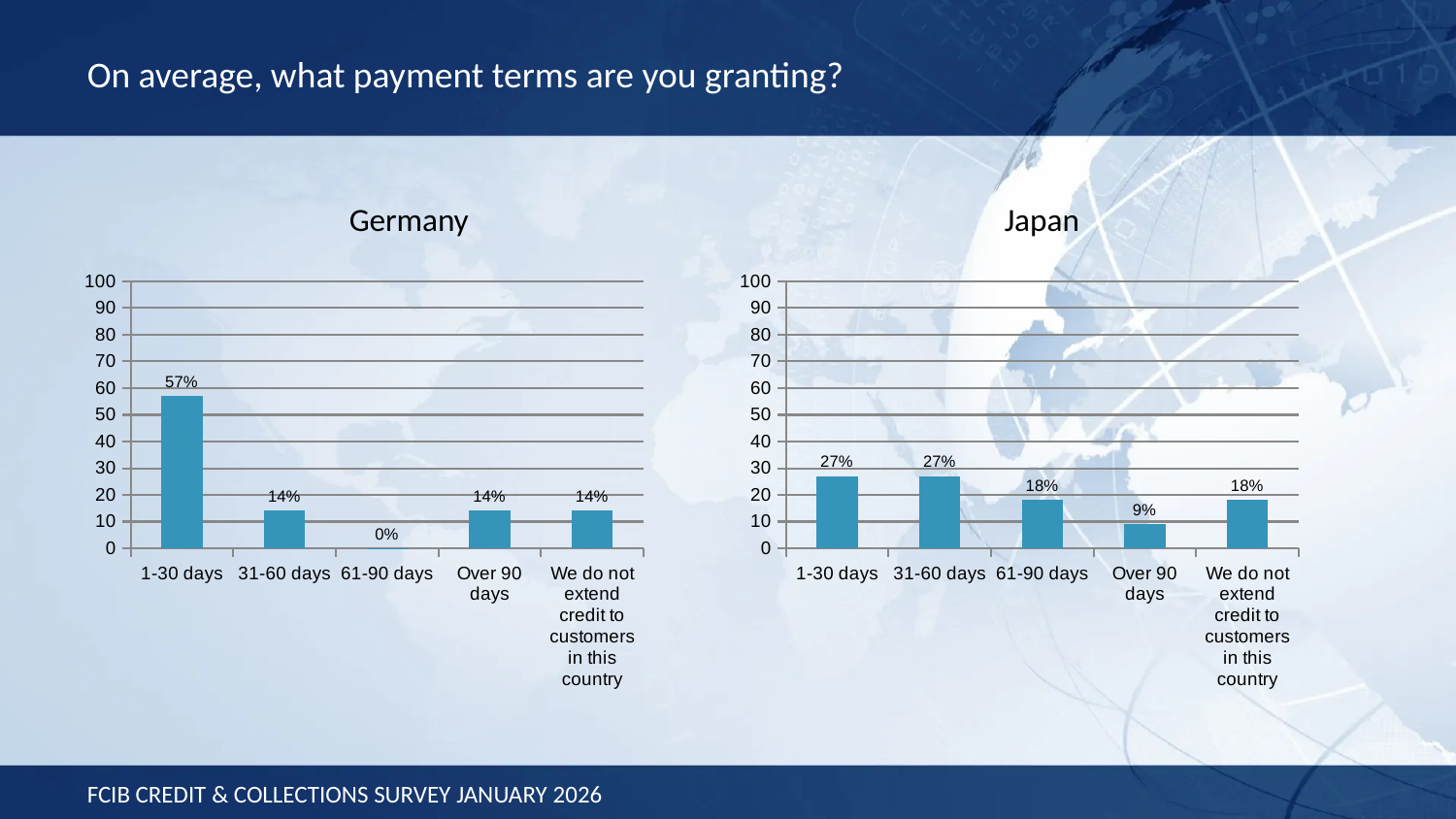
In the Japan chart, which category has the lowest value? Over 90 days What kind of chart is the Germany chart? bar chart In the Japan chart, what is the value for Over 90 days? 9% In the Japan chart, what is the value for 61-90 days? 18% How many categories are shown in the Japan chart? 5 In the Germany chart, what is the value for 1-30 days? 57% In the Germany chart, what is the difference between the values for 1-30 days and 31-60 days? 43% In the Germany chart, which category has the highest value? 1-30 days In the Germany chart, is the value for 1-30 days greater or less than 50? greater In the Germany chart, what is the value for 61-90 days? 0% Which is larger: the value for 1-30 days in the Germany chart or the value for 1-30 days in the Japan chart? Germany In the Japan chart, what is the difference between the values for 31-60 days and Over 90 days? 18%